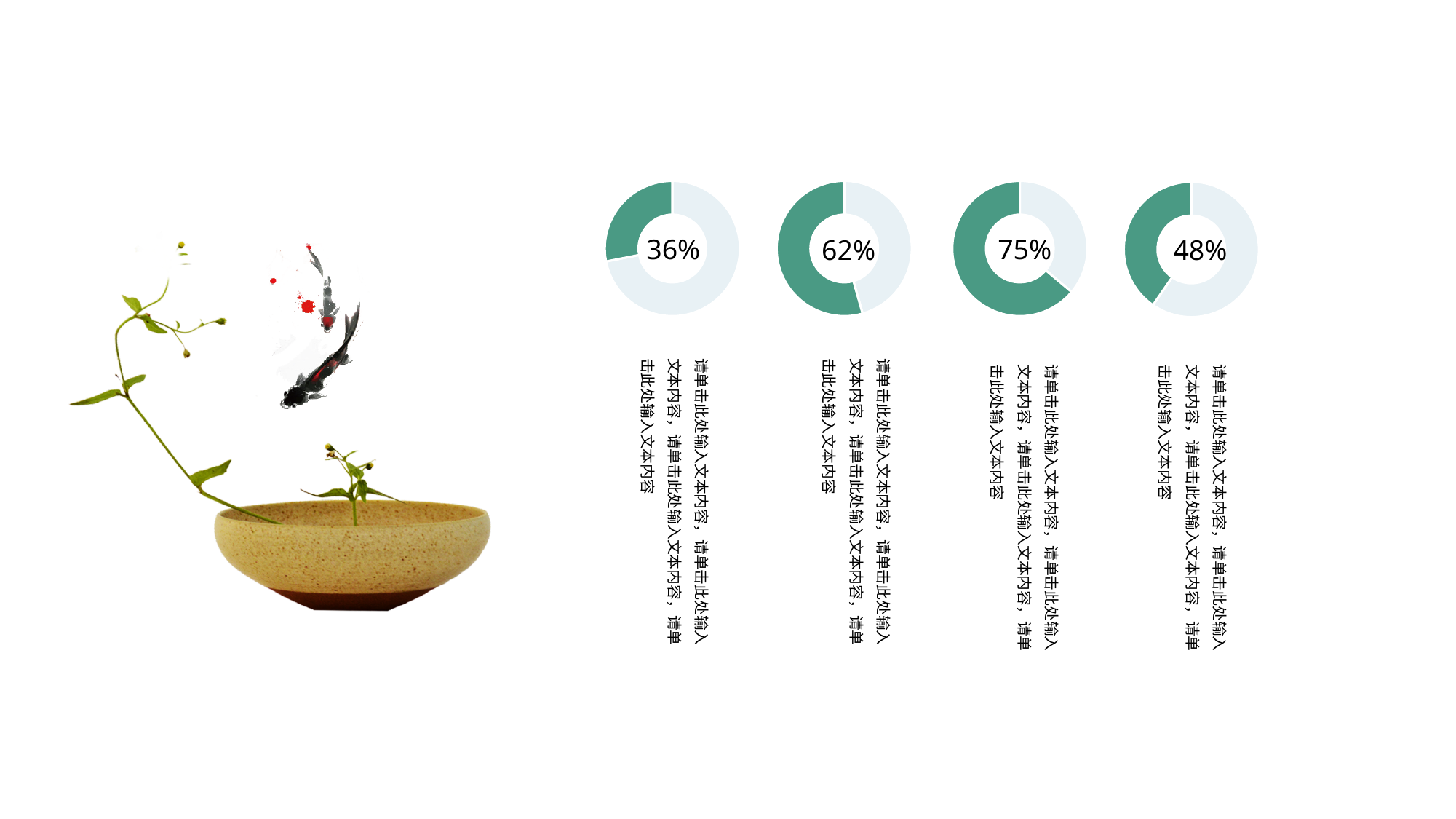
What kind of chart is used to display the percentages on the slide? Donut chart What percentage is shown in the third donut chart from the left? 75% What is the difference between the percentage in the third donut chart (75%) and the leftmost donut chart (36%)? 39% What colour is the filled portion of each donut chart? Green What percentage is shown in the rightmost donut chart? 48% Which donut chart shows the lowest percentage? The leftmost (36%) What percentage is shown in the second donut chart from the left? 62% What percentage is shown in the leftmost donut chart? 36% Which donut chart shows the highest percentage? The third from the left (75%) What is the difference between the percentage in the second donut chart (62%) and the rightmost donut chart (48%)? 14% Which is larger, the percentage in the second donut chart from the left or the rightmost donut chart? The second from the left (62%) How many donut charts are on the slide? 4